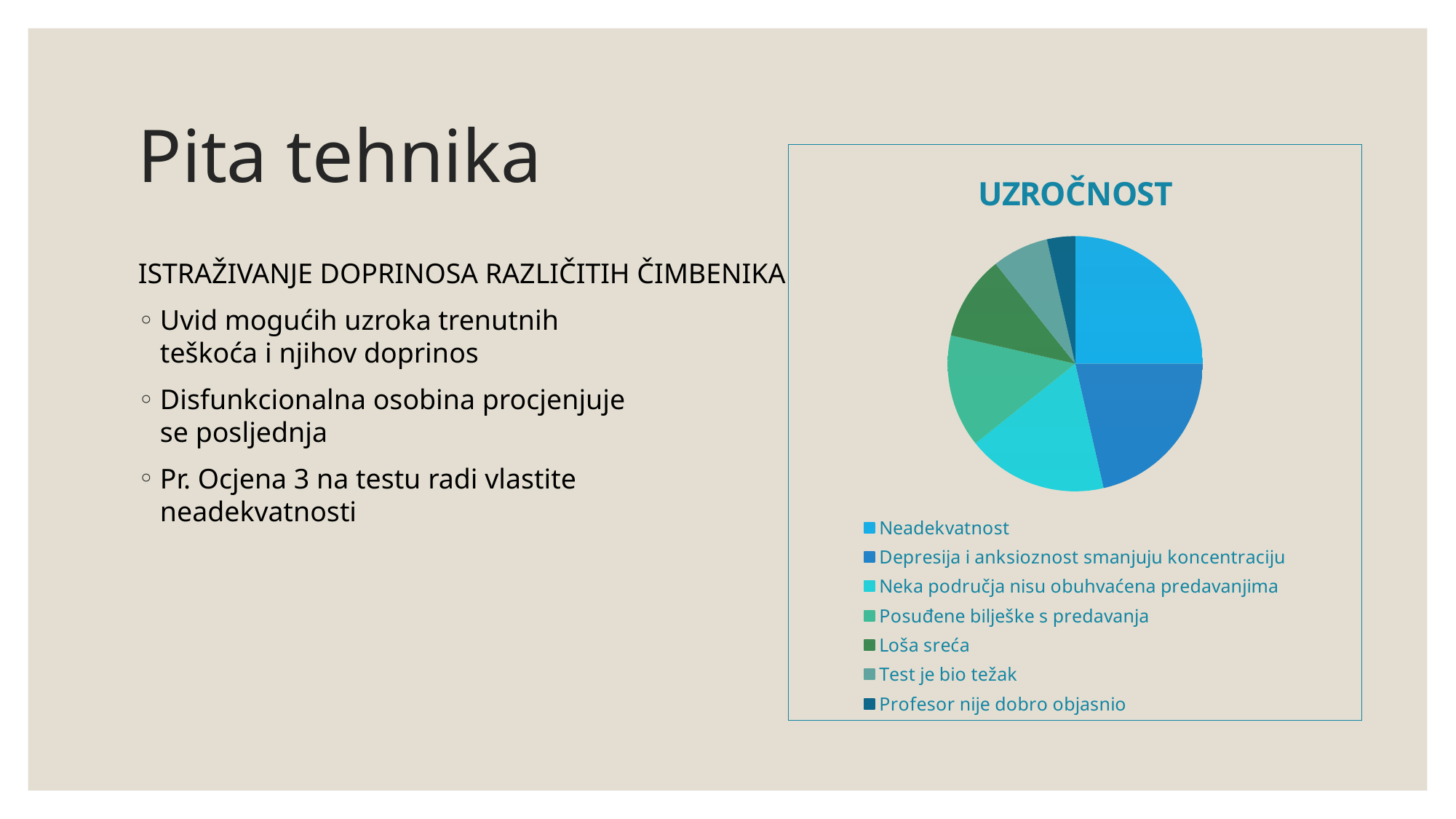
What kind of chart is shown on the slide? Pie chart Which slice is larger: Posuđene bilješke s predavanja or Profesor nije dobro objasnio? Posuđene bilješke s predavanja How many entries does the chart legend list? 7 Which legend entry is listed first in the chart legend? Neadekvatnost How many slices does the pie chart have? 7 Which category has the smallest slice in the pie chart? Profesor nije dobro objasnio Which category has the largest slice in the pie chart? Neadekvatnost Which slice is larger: Neadekvatnost or Loša sreća? Neadekvatnost Which slice is larger: Test je bio težak or Neka područja nisu obuhvaćena predavanjima? Neka područja nisu obuhvaćena predavanjima What is the title of the chart? UZROČNOST